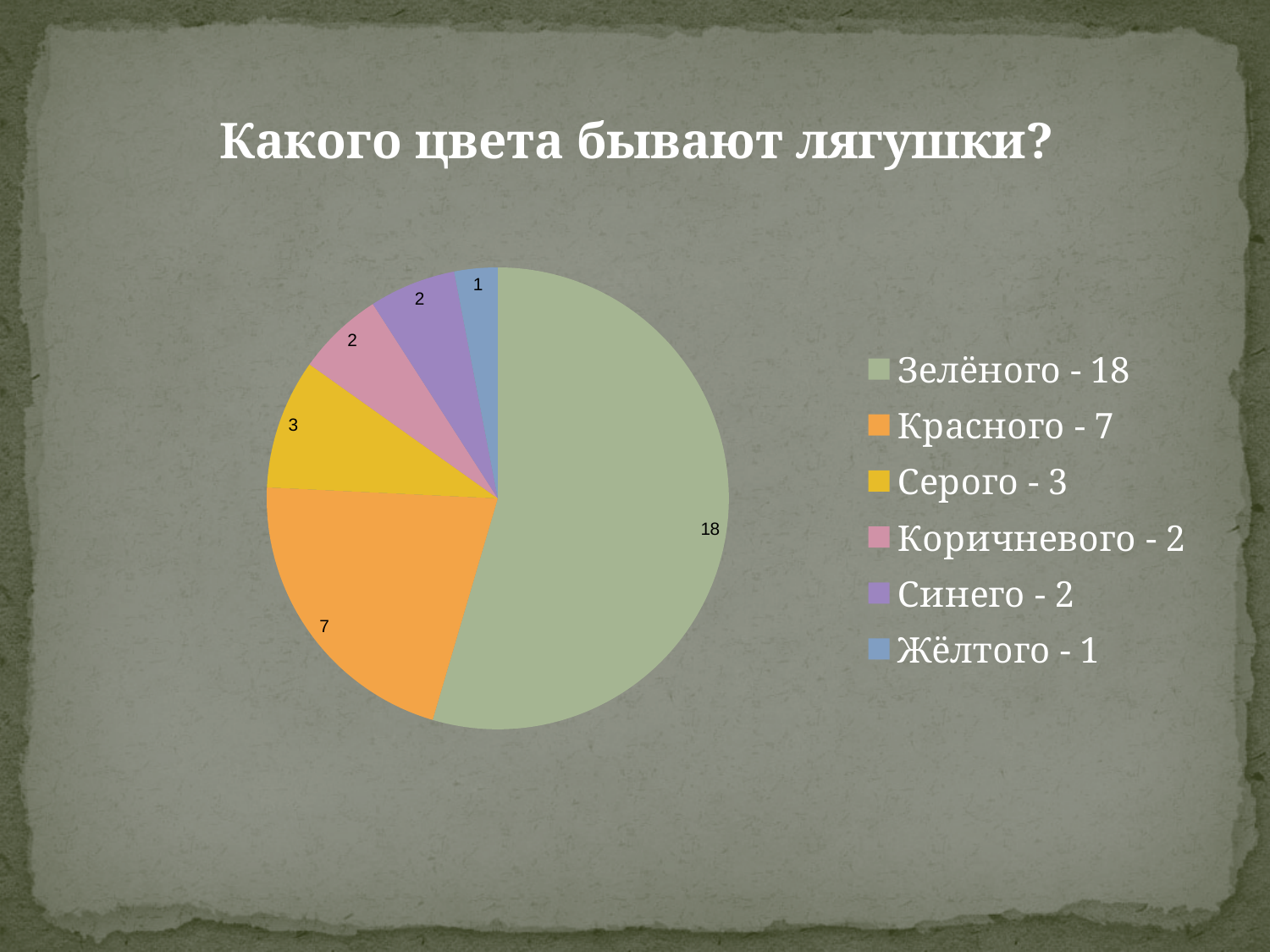
How many slices does the pie chart have? 6 What is the value for Красного? 7 What is the title of the chart? Какого цвета бывают лягушки? What kind of chart is shown on the slide? pie chart What is the value for Зелёного? 18 What is the total of all the slice values in the pie chart? 33 Which category has the largest slice? Зелёного Which category has the smallest slice? Жёлтого What is the value for Жёлтого? 1 What is the value for Серого? 3 Which is larger, the value for Серого or the value for Синего? Серого What is the difference between the values for Зелёного and Красного? 11